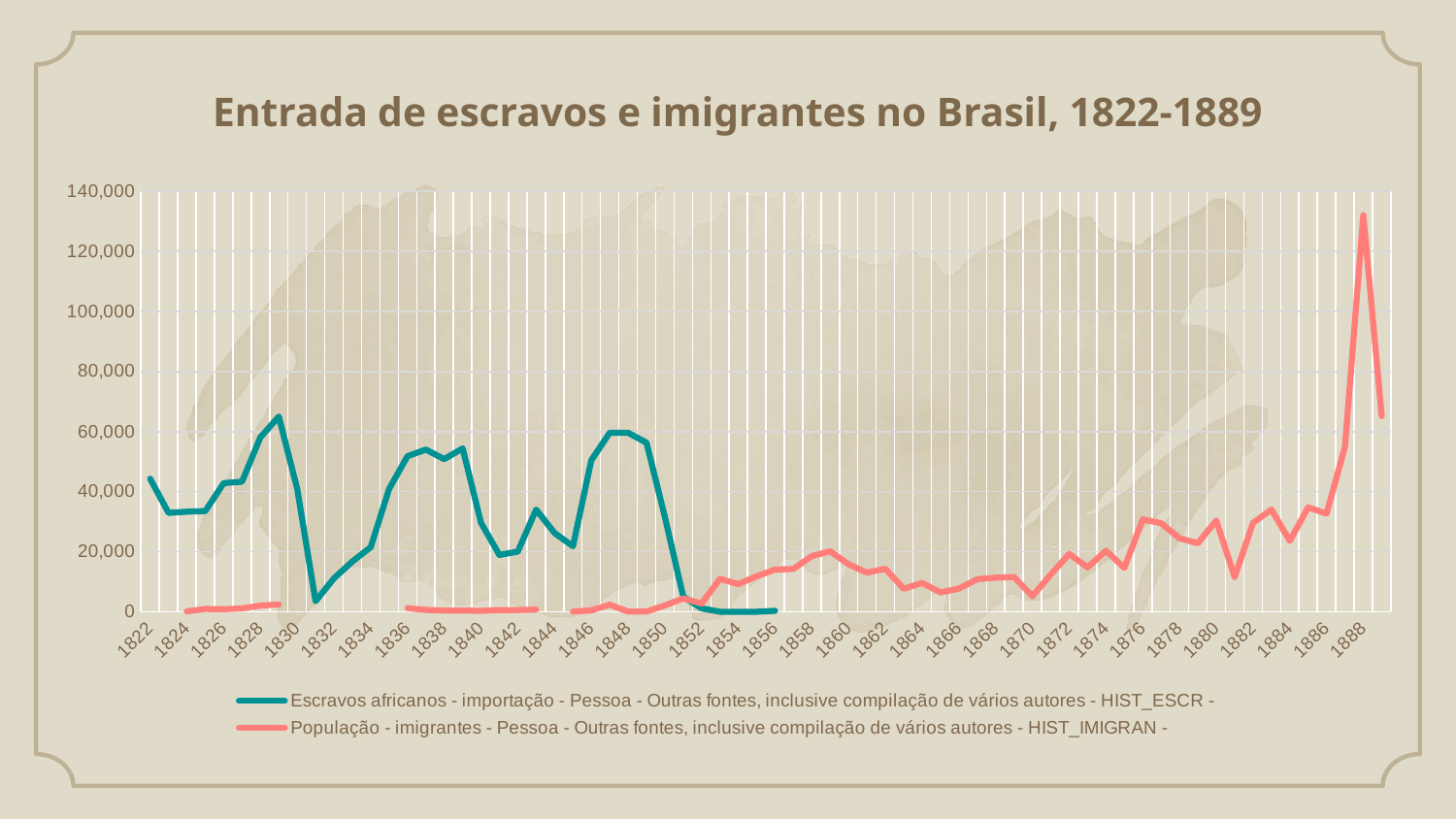
In which year does the immigrant population series (HIST_IMIGRAN) reach its highest value? 1888 Is the value of the immigrant series in 1860 greater or less than 40,000? less How many series does the legend list? 2 What kind of chart is shown on the slide? line chart In 1829, which series has the higher value: African slave imports or immigrants? African slave imports What colour is the line for the African slave import series (HIST_ESCR)? teal What is the title of the chart? Entrada de escravos e imigrantes no Brasil, 1822-1889 Is the value of the African slave import series in 1831 greater or less than 20,000? less Does the immigrant series generally rise or fall between 1870 and 1888? rise Is the value of the African slave import series in 1829 greater or less than 40,000? greater